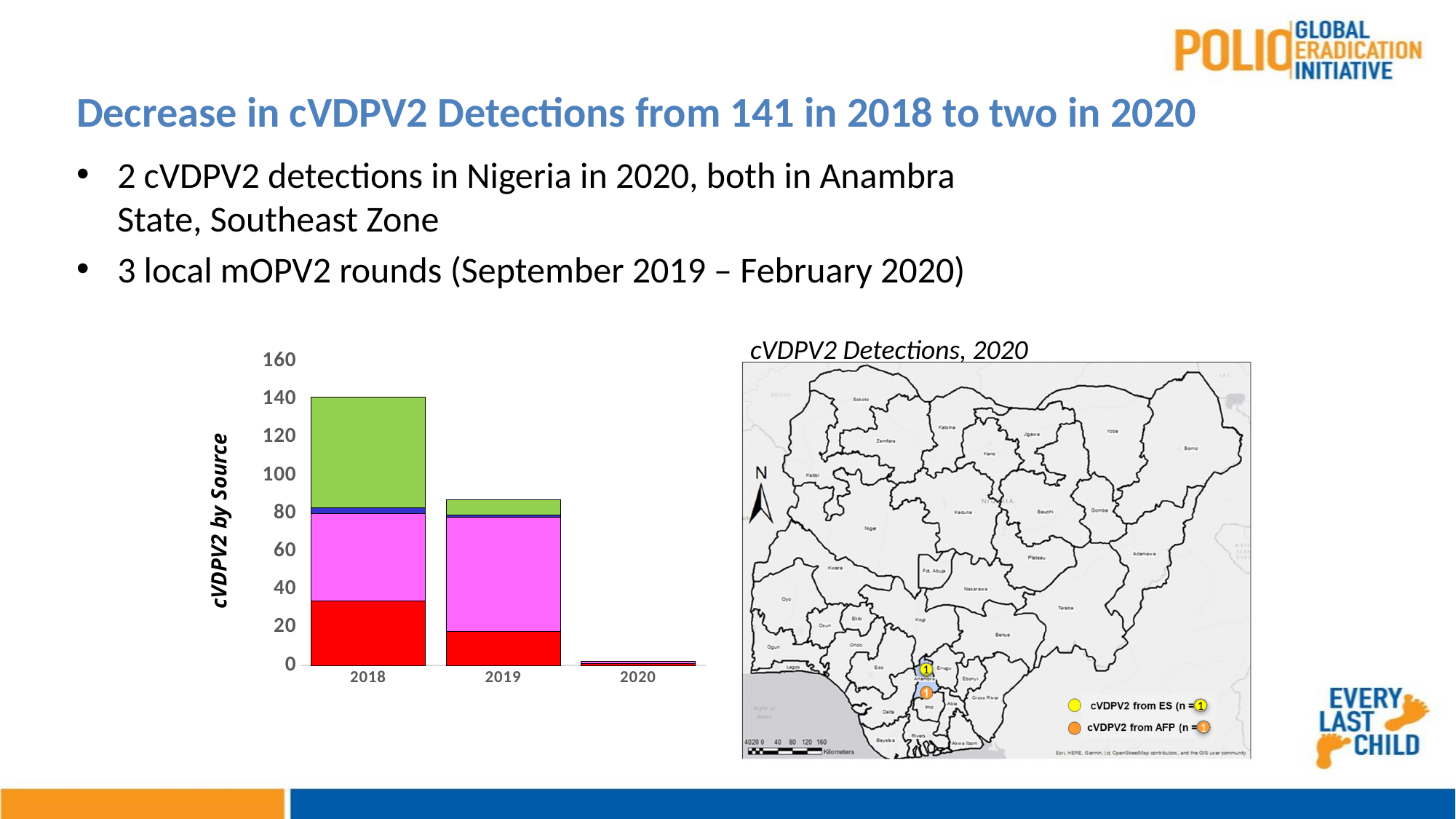
What is the highest value shown on the y axis of the bar chart? 160 Is the total for 2018 greater or less than 120? greater Is the total for 2019 greater or less than 100? less Which year has the shortest bar in the bar chart? 2020 What kind of chart is shown on the left of the slide? bar chart Is the red segment of the 2018 bar greater or less than 20? greater Which year has the tallest bar in the bar chart? 2018 Do the bar totals rise or fall from 2018 to 2020? fall What is the label on the y axis of the bar chart? cVDPV2 by Source How many years are shown on the x axis of the bar chart? 3 Which bar is taller, 2018 or 2019? 2018